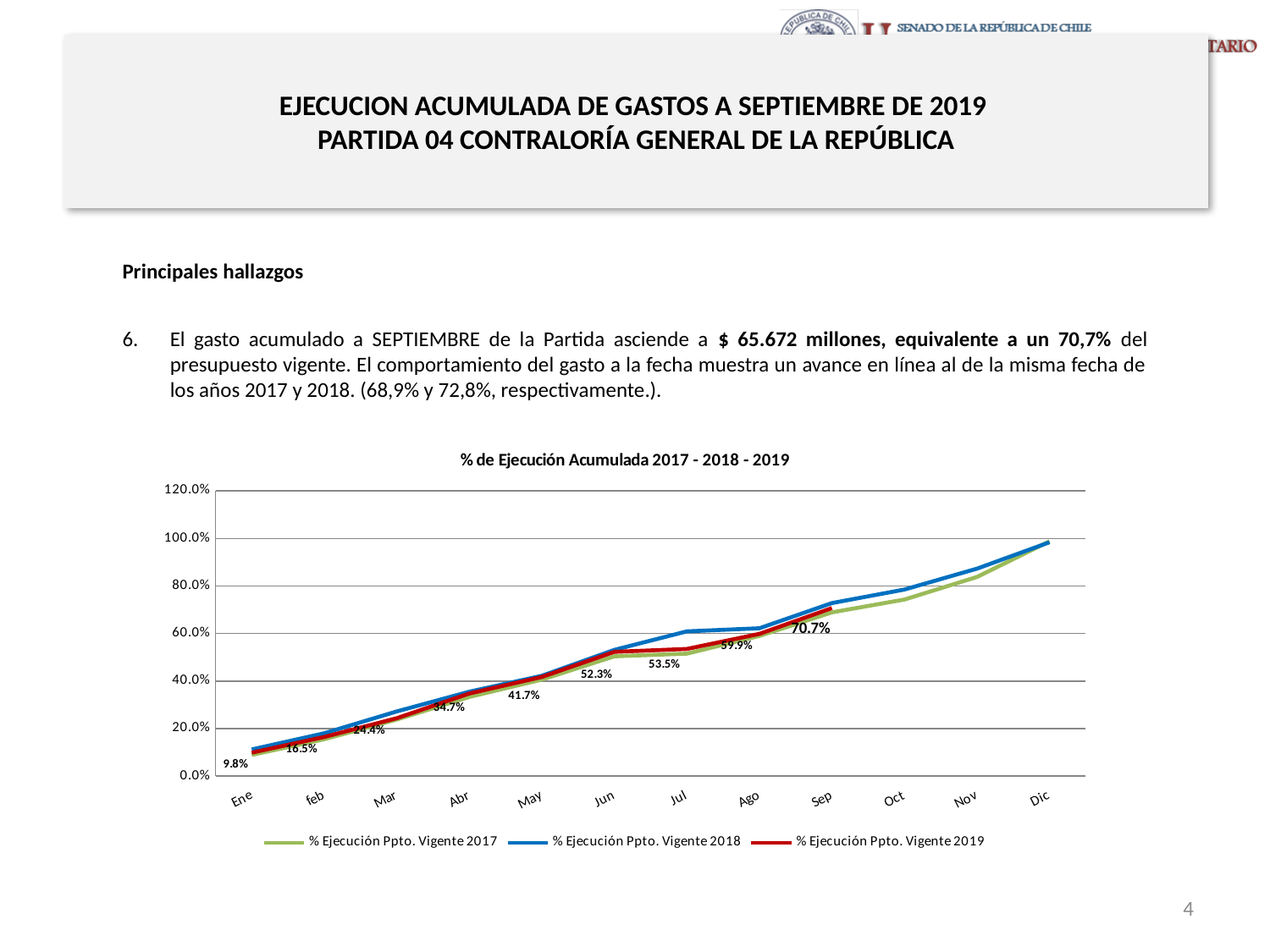
What is the value of % Ejecución Ppto. Vigente 2019 for Sep? 70.7% What is the title of the chart? % de Ejecución Acumulada 2017 - 2018 - 2019 Among the labelled 2019 values, which month has the highest value? Sep How many series does the legend of the chart list? 3 What is the difference between the 2019 values for Sep and Ago? 10.8 percentage points Is the value for % Ejecución Ppto. Vigente 2018 in Dic greater or less than 80.0%? greater Do the values of the 2019 series rise or fall from Ene to Sep? rise Which is larger for the 2019 series, the value for Jun or the value for Jul? Jul How many months are shown along the x axis of the chart? 12 What kind of chart is shown on the slide? line chart What is the value of % Ejecución Ppto. Vigente 2019 for May? 41.7% What is the value of % Ejecución Ppto. Vigente 2019 for Ene? 9.8%